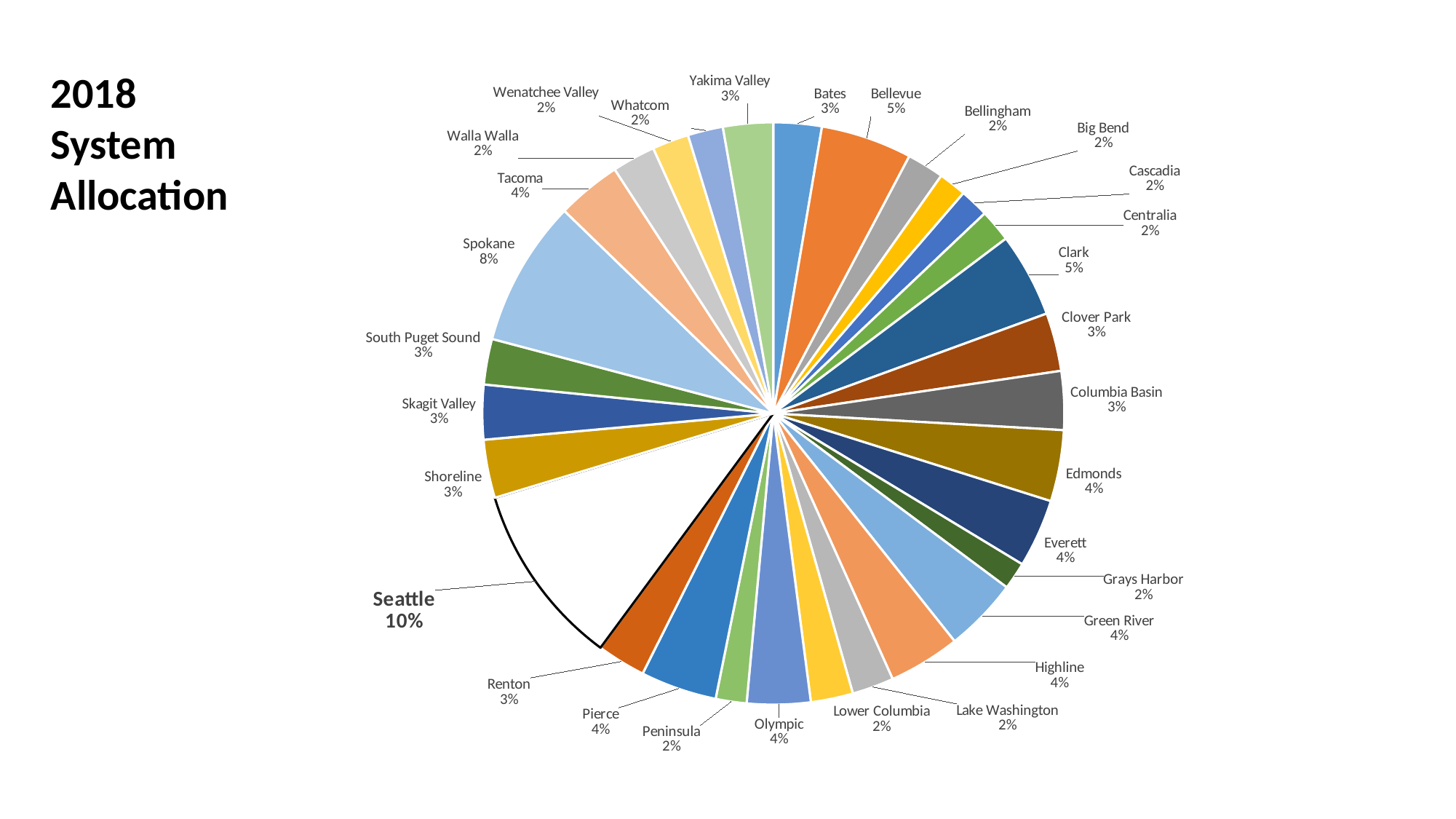
What share of the pie does Seattle have? 10% Which is larger, the share for Spokane or the share for Clark? Spokane What is the value shown for Bellevue? 5% Which college has the largest slice of the pie? Seattle What is the value shown for Wenatchee Valley? 2% What share of the pie does Spokane have? 8% What is the value shown for Tacoma? 4% What is the title of the chart? 2018 System Allocation How many colleges are shown as slices in the pie chart? 30 What is the value shown for Clark? 5% What is the difference in percentage points between Seattle's share and Spokane's share? 2 What kind of chart is shown on the slide? pie chart